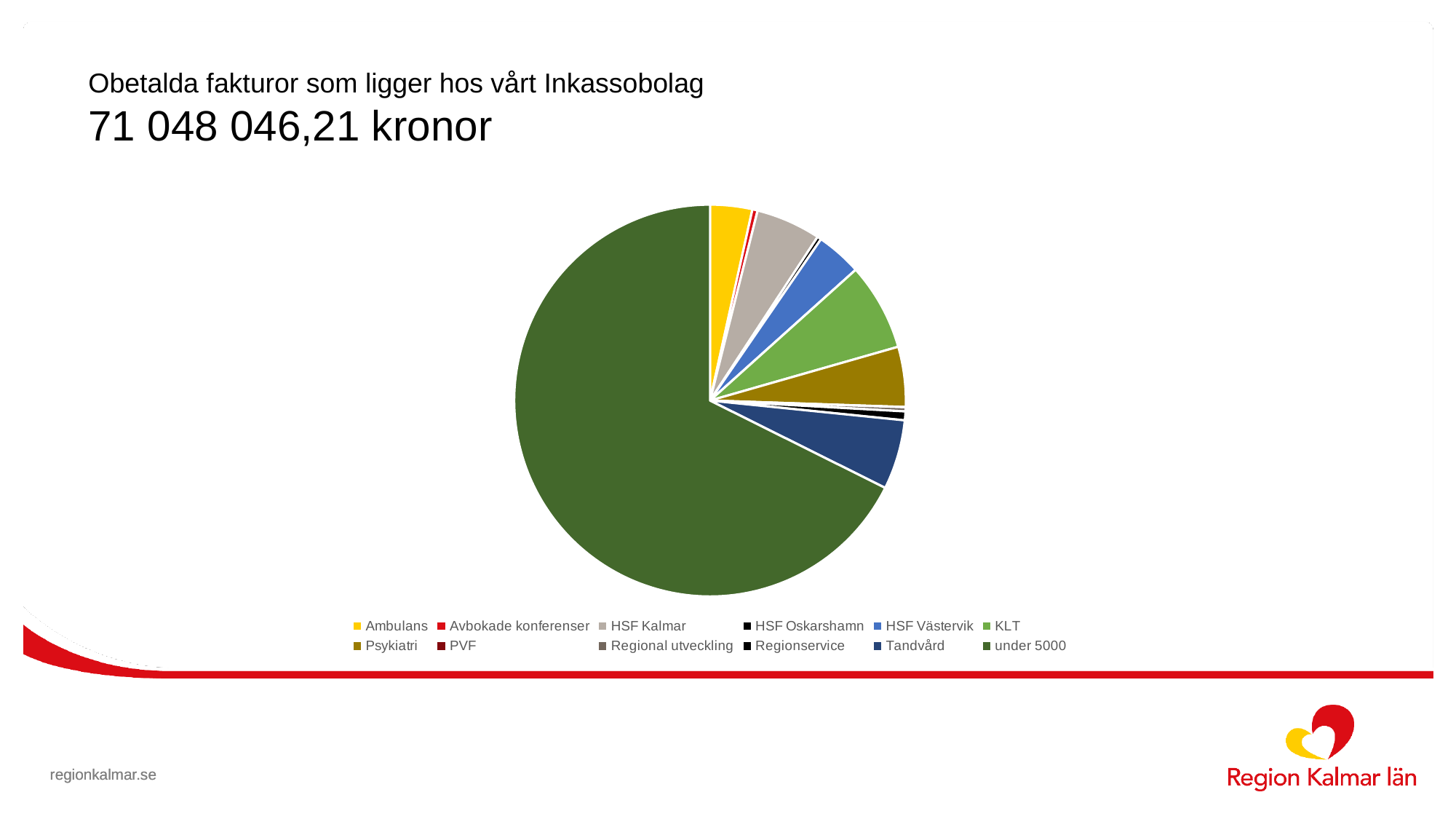
Which category has the largest slice of the pie chart? under 5000 Which slice is larger, Psykiatri or HSF Oskarshamn? Psykiatri Which slice is larger, Tandvård or Avbokade konferenser? Tandvård Does the 'under 5000' slice account for more or less than half of the pie? more Which slice is larger, KLT or Ambulans? KLT How many categories does the pie chart's legend list? 12 What total amount in kronor is stated on the slide? 71 048 046,21 kronor What is the title text above the pie chart? Obetalda fakturor som ligger hos vårt Inkassobolag What kind of chart is shown on the slide? pie chart